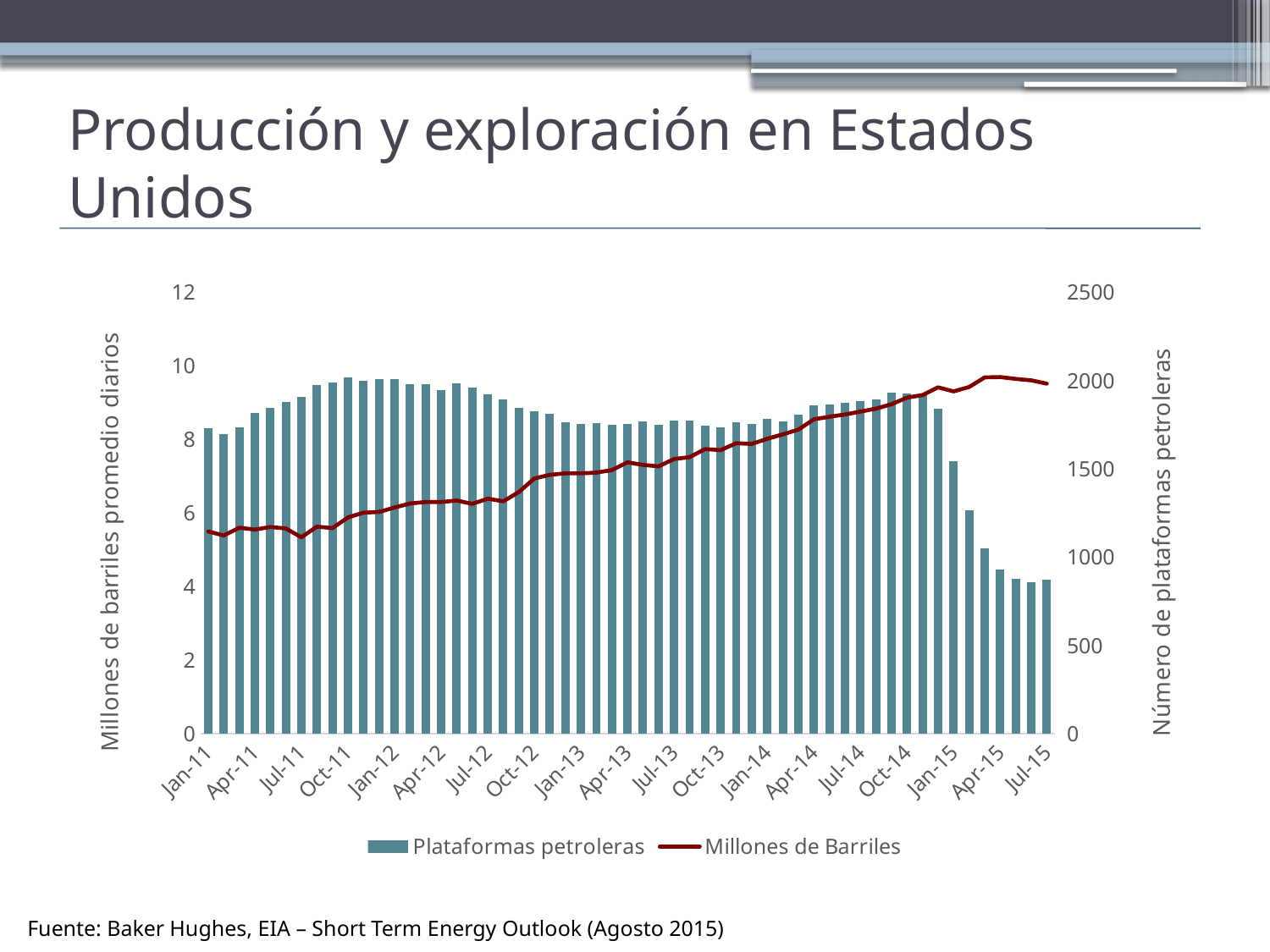
How many series does the legend list? 2 Is the value of Millones de Barriles for Jan-13 greater or less than 6? greater Which is larger, the Plataformas petroleras value for Jan-11 or for Jul-15? Jan-11 What is the title of the right-hand vertical axis? Número de plataformas petroleras Do the Plataformas petroleras bars rise or fall from Oct-14 to Jul-15? fall Is the value of Millones de Barriles for Jul-15 greater or less than 8? greater Which series is drawn as bars? Plataformas petroleras Does the Millones de Barriles line generally rise or fall from Jan-11 to Jul-15? rise Is the value of Plataformas petroleras for Jan-11 greater or less than 1500? greater What kind of chart is shown on the slide? A combined bar and line chart